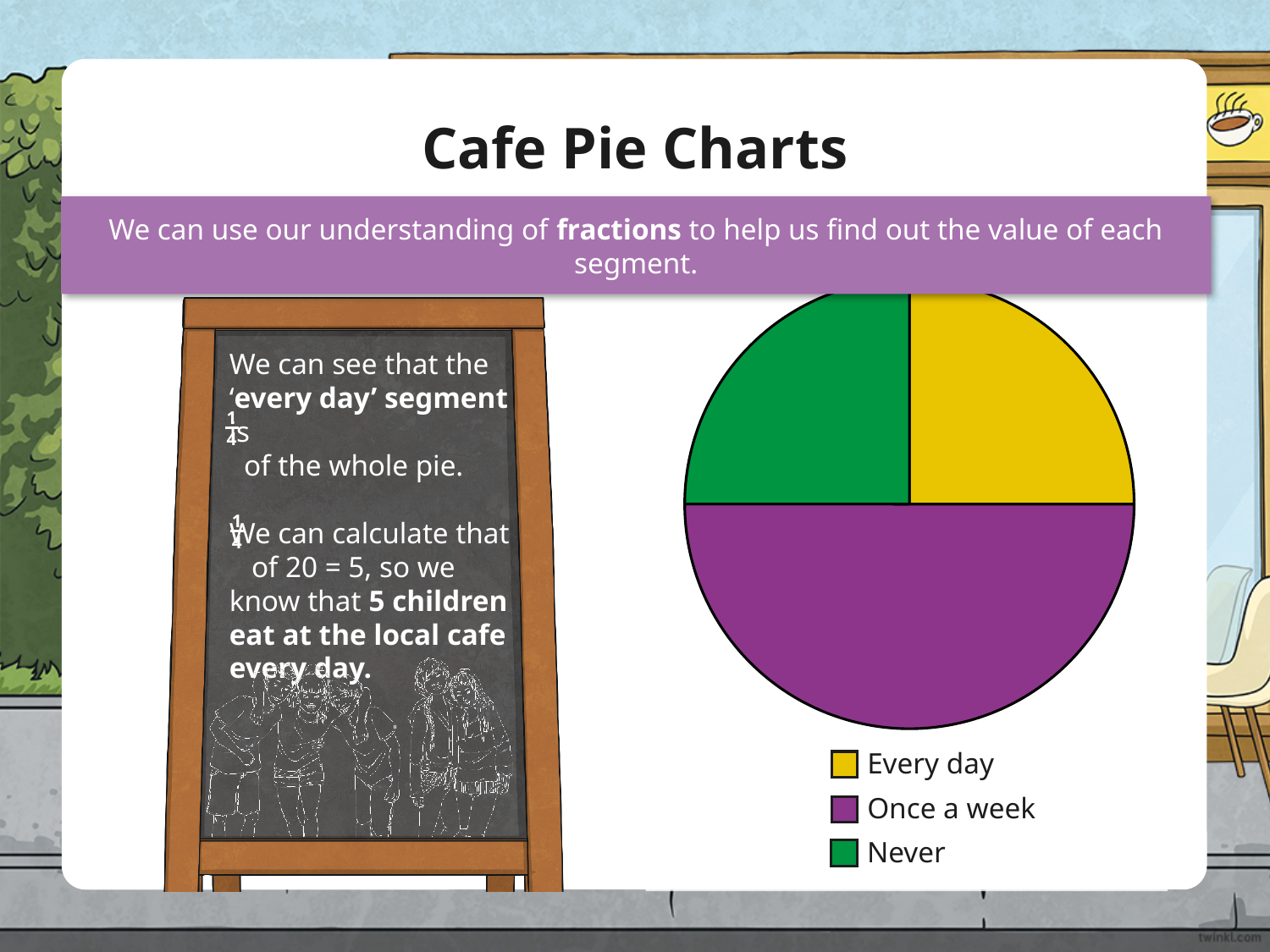
What fraction of the whole pie is the 'Every day' segment? 1/4 How many entries does the legend of the pie chart list? 3 Which segment is larger in the pie chart, 'Once a week' or 'Never'? Once a week According to the slide, how many children eat at the local cafe every day? 5 What colour is the 'Once a week' segment in the pie chart? purple Which category has the largest segment in the pie chart? Once a week Which segment is larger in the pie chart, 'Once a week' or 'Every day'? Once a week Which category is shown in green in the pie chart? Never How many segments does the pie chart have? 3 What kind of chart is shown on the slide? pie chart